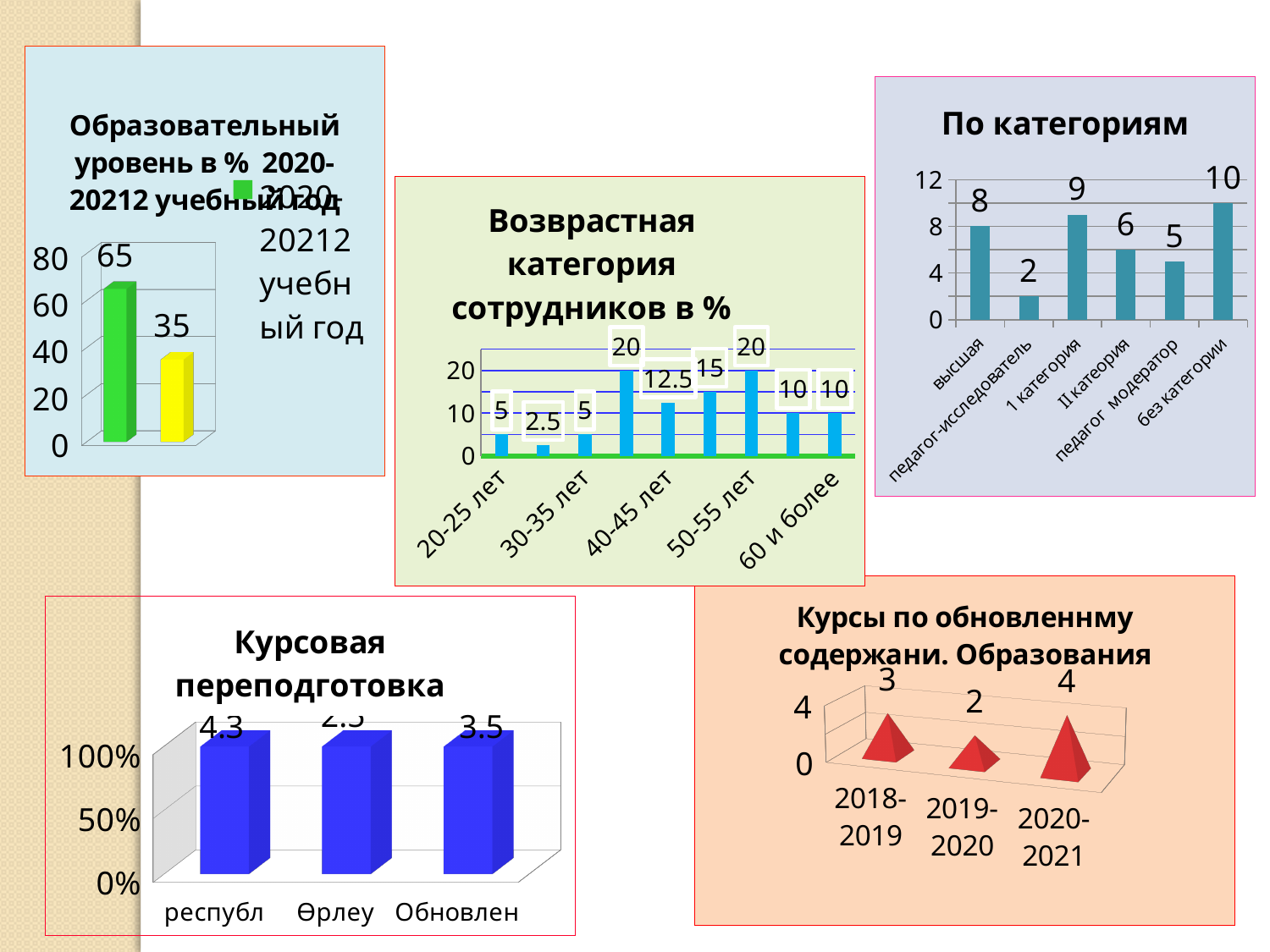
In the chart titled "Курсы по обновленнму содержани. Образования", what is the value for 2020-2021? 4 In the chart titled "Возврастная категория сотрудников в %", what is the smallest data label shown? 2.5 In the chart titled "Образовательный уровень в %", what is the difference between the two bar values? 30 In the chart titled "По категориям", what is the value for "высшая"? 8 In the chart titled "По категориям", what is the value for "педагог-исследователь"? 2 In the chart titled "Курсовая переподготовка", what is the data label on the bar for "республ"? 4.3 In the chart titled "По категориям", which category has the lowest value? педагог-исследователь In the chart titled "По категориям", how many categories are shown on the x axis? 6 In the chart titled "По категориям", what is the difference between the values for "1 категория" and "II категория"? 3 In the chart titled "Образовательный уровень в %", what is the value of the green bar? 65 In the chart titled "Курсы по обновленнму содержани. Образования", which period has the lowest value? 2019-2020 In the chart titled "По категориям", which category has the highest value? без категории